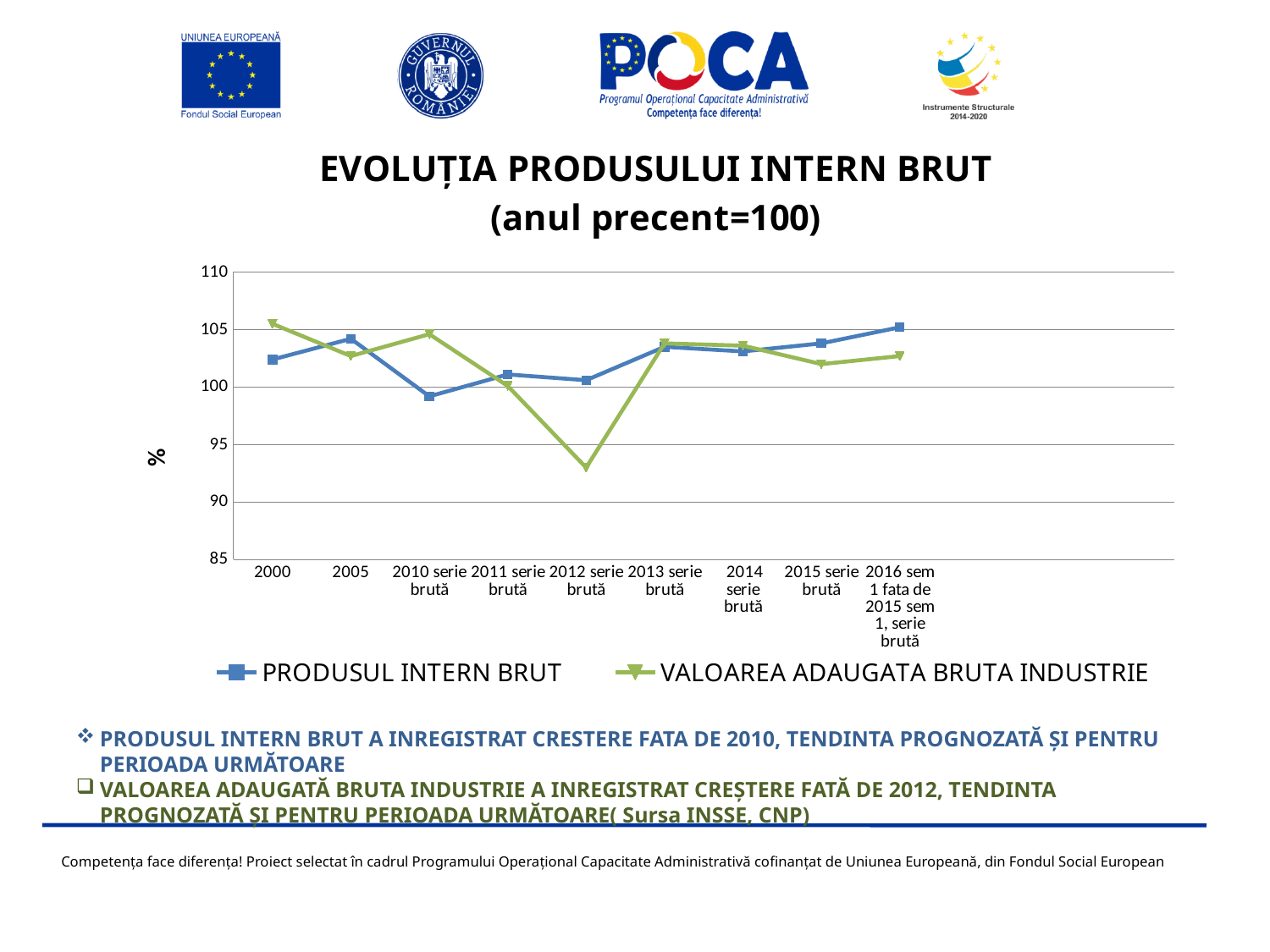
What kind of chart is shown on the slide? line chart Is the value for VALOAREA ADAUGATA BRUTA INDUSTRIE in 2000 greater or less than 105? greater Is the value for VALOAREA ADAUGATA BRUTA INDUSTRIE in 2012 serie brută greater or less than 95? less Which category has the lowest value for VALOAREA ADAUGATA BRUTA INDUSTRIE? 2012 serie brută What is the label on the vertical axis of the chart? % In 2000, which series has the larger value, PRODUSUL INTERN BRUT or VALOAREA ADAUGATA BRUTA INDUSTRIE? VALOAREA ADAUGATA BRUTA INDUSTRIE Which category has the highest value for VALOAREA ADAUGATA BRUTA INDUSTRIE? 2000 Which category has the lowest value for PRODUSUL INTERN BRUT? 2010 serie brută How many categories are shown on the x axis? 9 Is the value for PRODUSUL INTERN BRUT in 2010 serie brută greater or less than 100? less How many series does the legend list? 2 In 2012 serie brută, which series has the larger value, PRODUSUL INTERN BRUT or VALOAREA ADAUGATA BRUTA INDUSTRIE? PRODUSUL INTERN BRUT